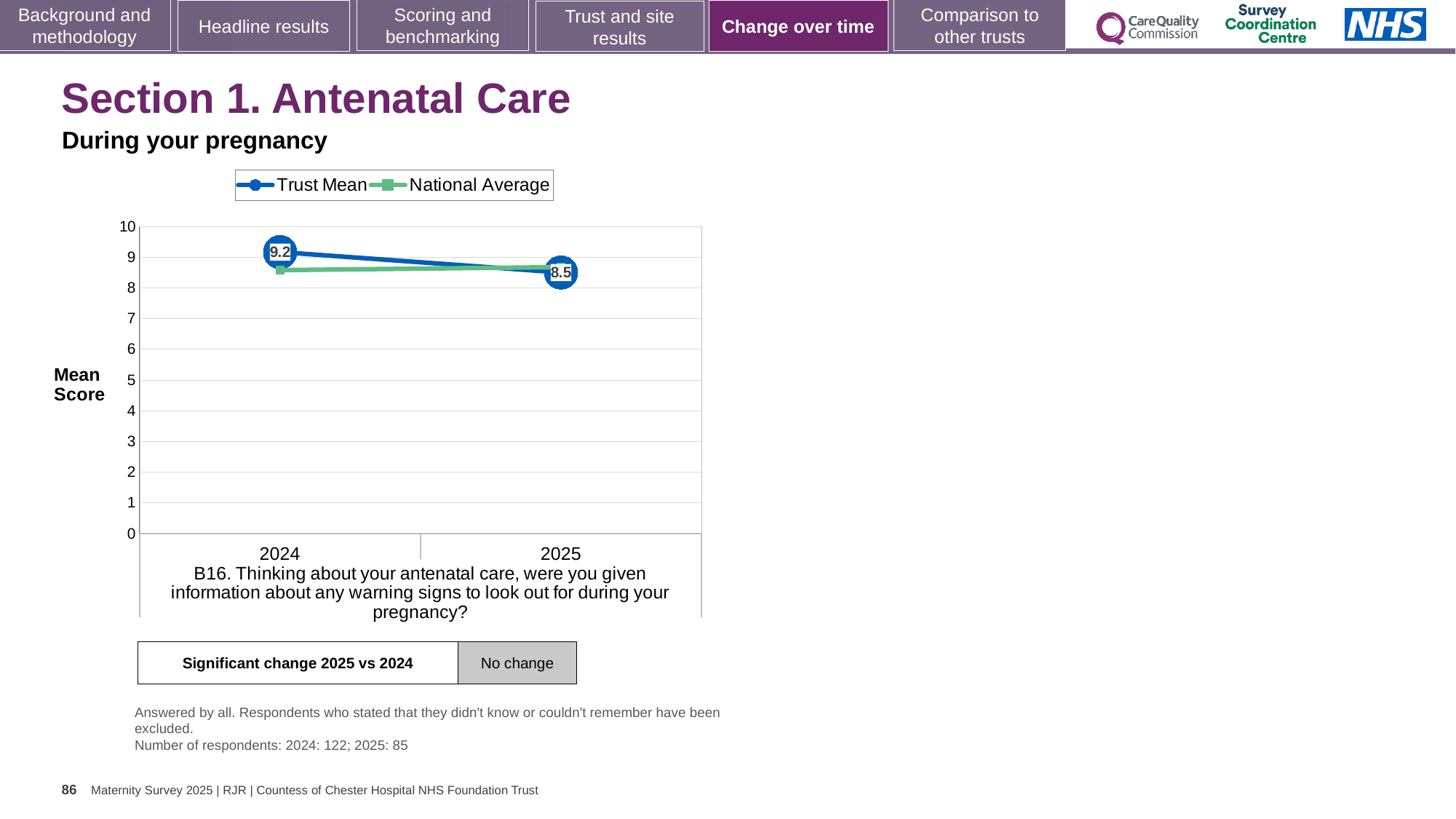
What is the Trust Mean score for 2024? 9.2 How many years are plotted on the x axis? 2 Which year has the higher Trust Mean score, 2024 or 2025? 2024 What kind of chart is shown on the slide? line chart By how much did the Trust Mean score fall from 2024 to 2025? 0.7 Does the Trust Mean rise or fall from 2024 to 2025? fall Is the National Average value for 2024 greater or less than 8? greater In which year is the Trust Mean at its lowest? 2025 In which year is the Trust Mean at its highest? 2024 How many series does the legend list? 2 What is the Trust Mean score for 2025? 8.5 What is the label on the y axis of the chart? Mean Score